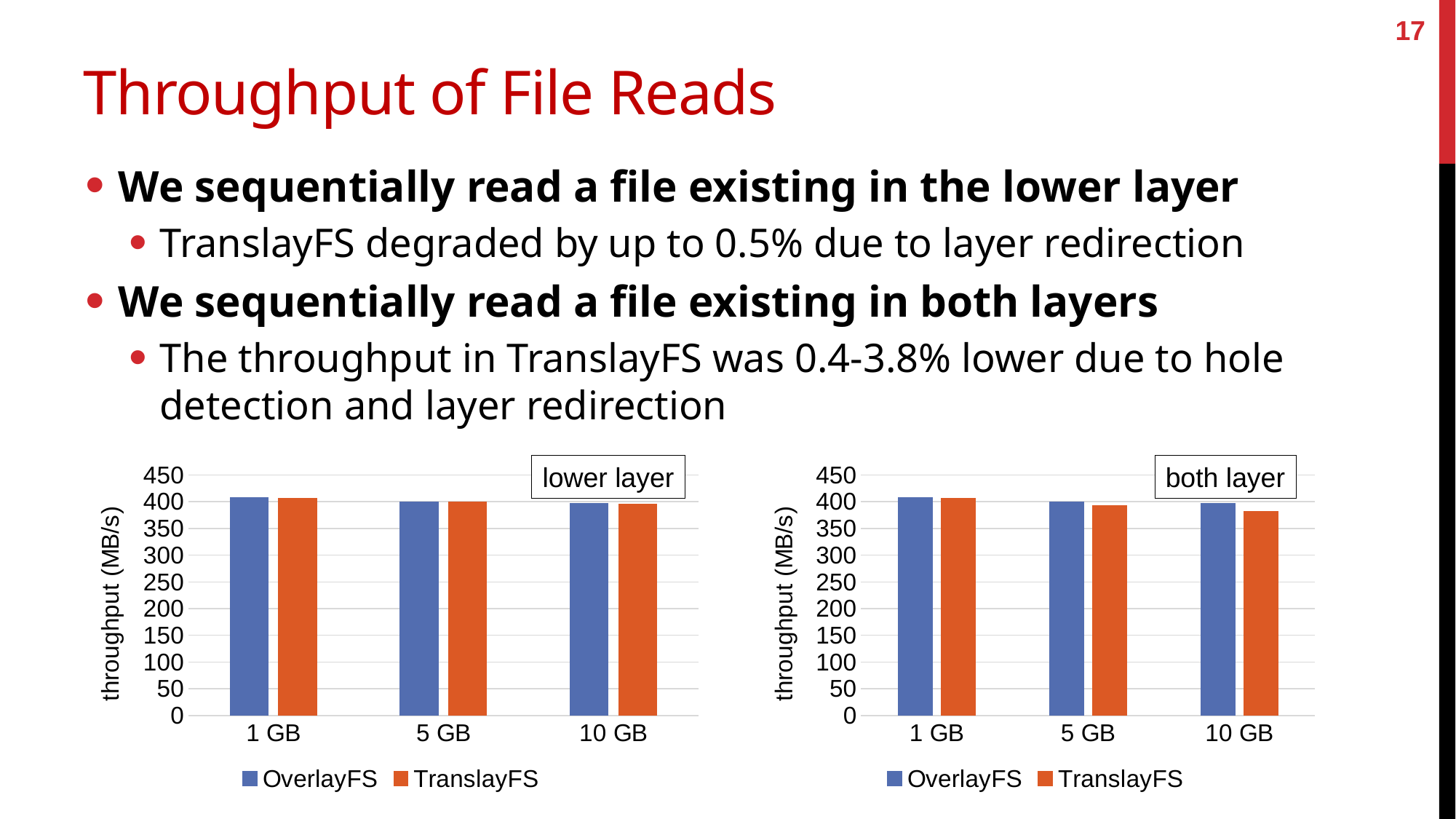
In the 'lower layer' chart, is the TranslayFS value for 5 GB greater or less than 300? greater In the 'both layer' chart, which file size has the lowest TranslayFS throughput? 10 GB Which series is shown in orange in the 'both layer' chart? TranslayFS In the 'both layer' chart, is the OverlayFS value for 5 GB greater or less than 450? less How many series does the legend of the 'lower layer' chart list? 2 What is the y-axis label of the 'lower layer' chart? throughput (MB/s) In the 'both layer' chart, is the TranslayFS value for 10 GB greater or less than 400? less What kind of chart is the 'lower layer' chart? bar chart In the 'both layer' chart, does the TranslayFS throughput rise or fall as the file size increases from 1 GB to 10 GB? fall How many file-size categories are shown on the x axis of the 'both layer' chart? 3 In the 'both layer' chart, which series has the larger value for 10 GB, OverlayFS or TranslayFS? OverlayFS